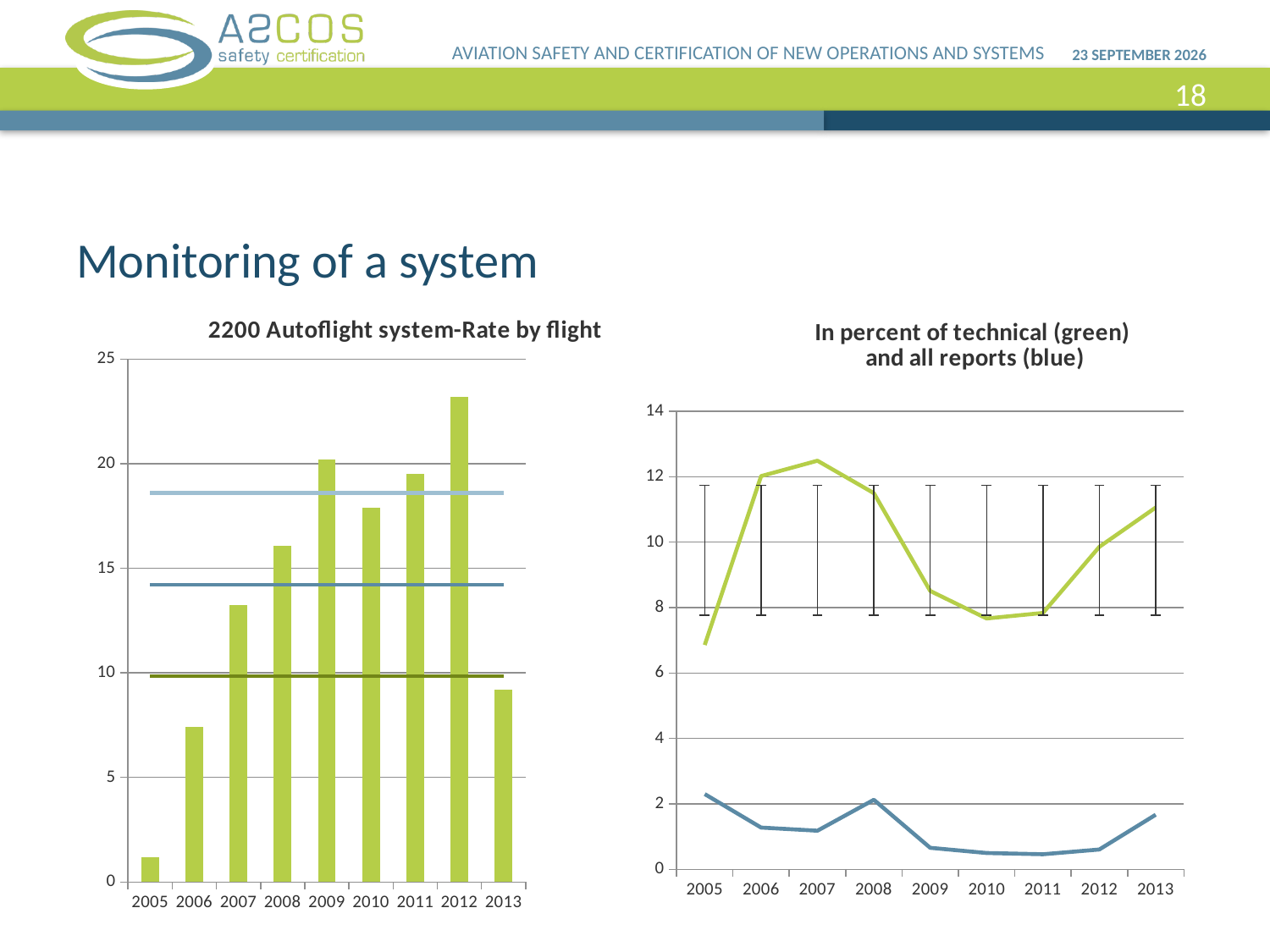
In the 'In percent of technical (green) and all reports (blue)' chart, which year has the lowest value on the green line? 2005 In the '2200 Autoflight system-Rate by flight' chart, which is larger, the value for 2009 or the value for 2010? 2009 How many years are shown on the x axis of the '2200 Autoflight system-Rate by flight' chart? 9 In the '2200 Autoflight system-Rate by flight' chart, which year has the highest bar? 2012 In the '2200 Autoflight system-Rate by flight' chart, do the bars rise or fall from 2005 to 2009? rise In the 'In percent of technical (green) and all reports (blue)' chart, is the blue line value for 2005 greater or less than 2? greater In the '2200 Autoflight system-Rate by flight' chart, is the value for 2013 greater or less than 10? less What kind of chart is the '2200 Autoflight system-Rate by flight' chart on the left? bar chart What kind of chart is the 'In percent of technical (green) and all reports (blue)' chart on the right? line chart In the '2200 Autoflight system-Rate by flight' chart, which year has the lowest bar? 2005 In the '2200 Autoflight system-Rate by flight' chart, is the value for 2012 greater or less than 20? greater